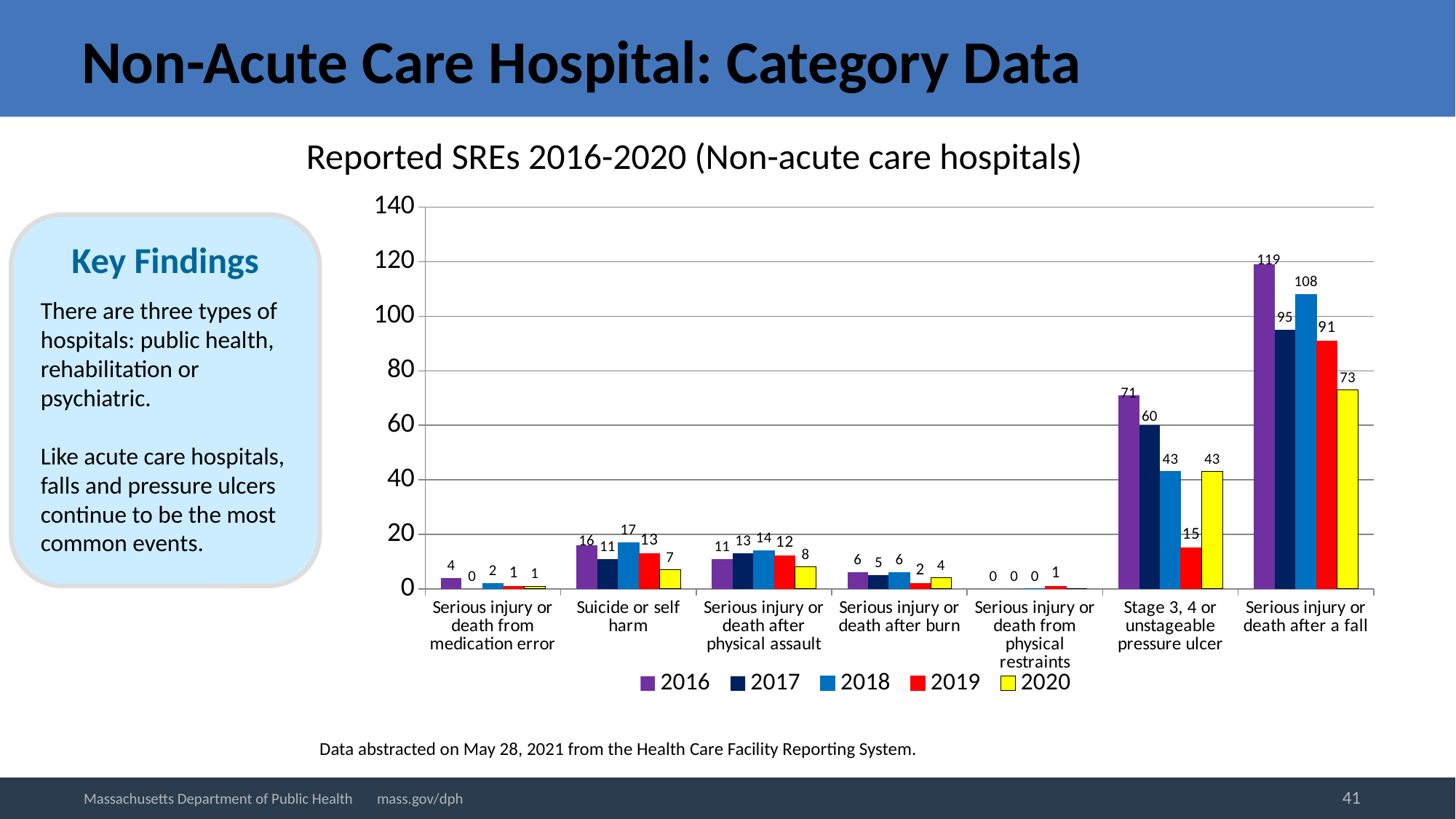
How many series does the legend list? 5 What is the 2020 value for Suicide or self harm? 7 What is the title of the chart? Reported SREs 2016-2020 (Non-acute care hospitals) Which is larger for Stage 3, 4 or unstageable pressure ulcer: the 2016 value or the 2017 value? 2016 Do the values for Stage 3, 4 or unstageable pressure ulcer rise or fall from 2016 to 2019? fall What is the 2016 value for Serious injury or death after a fall? 119 How many categories are shown on the x axis? 7 What is the difference between the 2016 and 2020 values for Serious injury or death after a fall? 46 What is the 2019 value for Stage 3, 4 or unstageable pressure ulcer? 15 Which category has the highest 2018 value? Serious injury or death after a fall What type of chart is shown on the slide? bar chart What is the 2017 value for Serious injury or death from medication error? 0